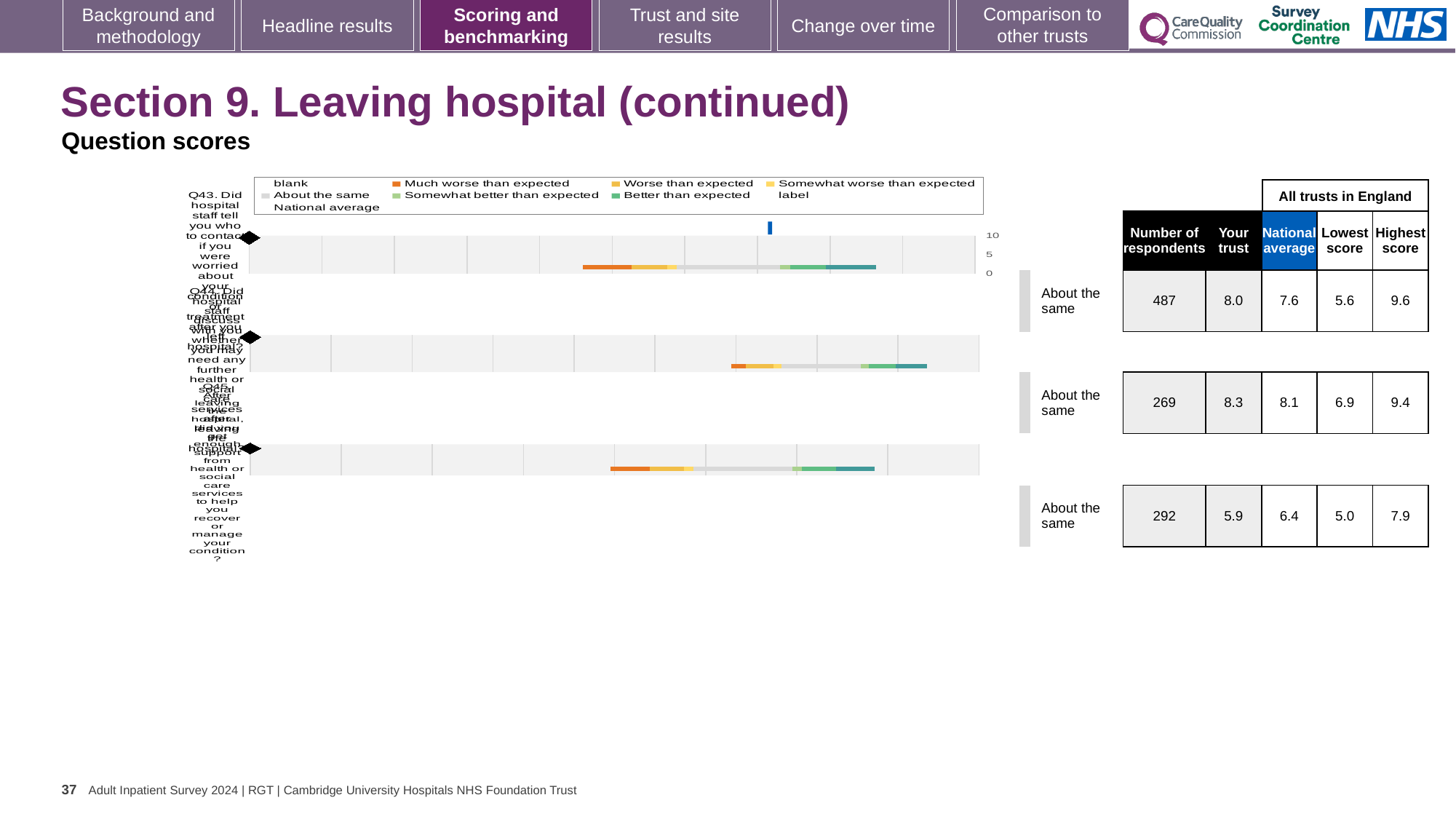
What is the difference between the highest score and the lowest score for Q45? 2.9 What is the highest score among all trusts in England for Q44? 9.4 Is the 'Your trust' score for Q43 larger or smaller than the national average for Q43? larger How many question bars are plotted in the chart? 3 What is the benchmark category shown for all three questions? About the same How many respondents answered Q43? 487 What kind of chart is shown on the slide? bar chart What is the national average score for Q44 (the middle bar)? 8.1 Which question has the lowest 'Your trust' score? Q45 Which question has the highest 'Your trust' score? Q44 What is the 'Your trust' score for Q43 (the top bar)? 8.0 What is the 'Your trust' score for Q45 (the bottom bar)? 5.9